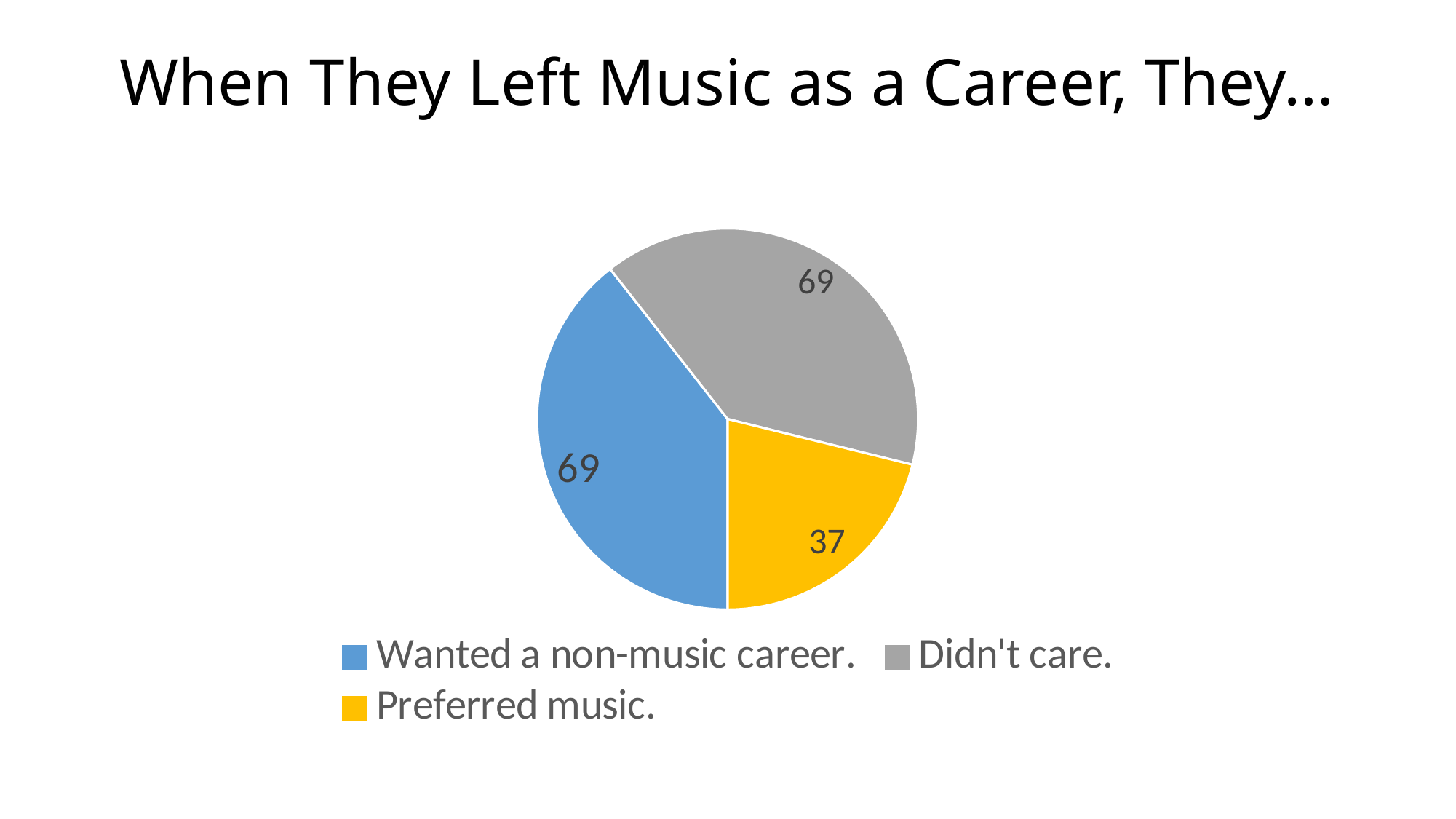
How many slices does the pie chart have? 3 What value is shown for the "Preferred music." slice? 37 How many entries does the legend list? 3 What colour is the "Didn't care." slice? Gray What is the difference between the values for "Didn't care." and "Preferred music."? 32 What is the total of all the slice values in the pie chart? 175 What value is shown for the "Didn't care." slice? 69 What is the title of the chart? When They Left Music as a Career, They... Which category has the smallest slice of the pie? Preferred music. What value is shown for the "Wanted a non-music career." slice? 69 Which is larger, the value for "Wanted a non-music career." or the value for "Preferred music."? Wanted a non-music career. What kind of chart is shown on the slide? Pie chart